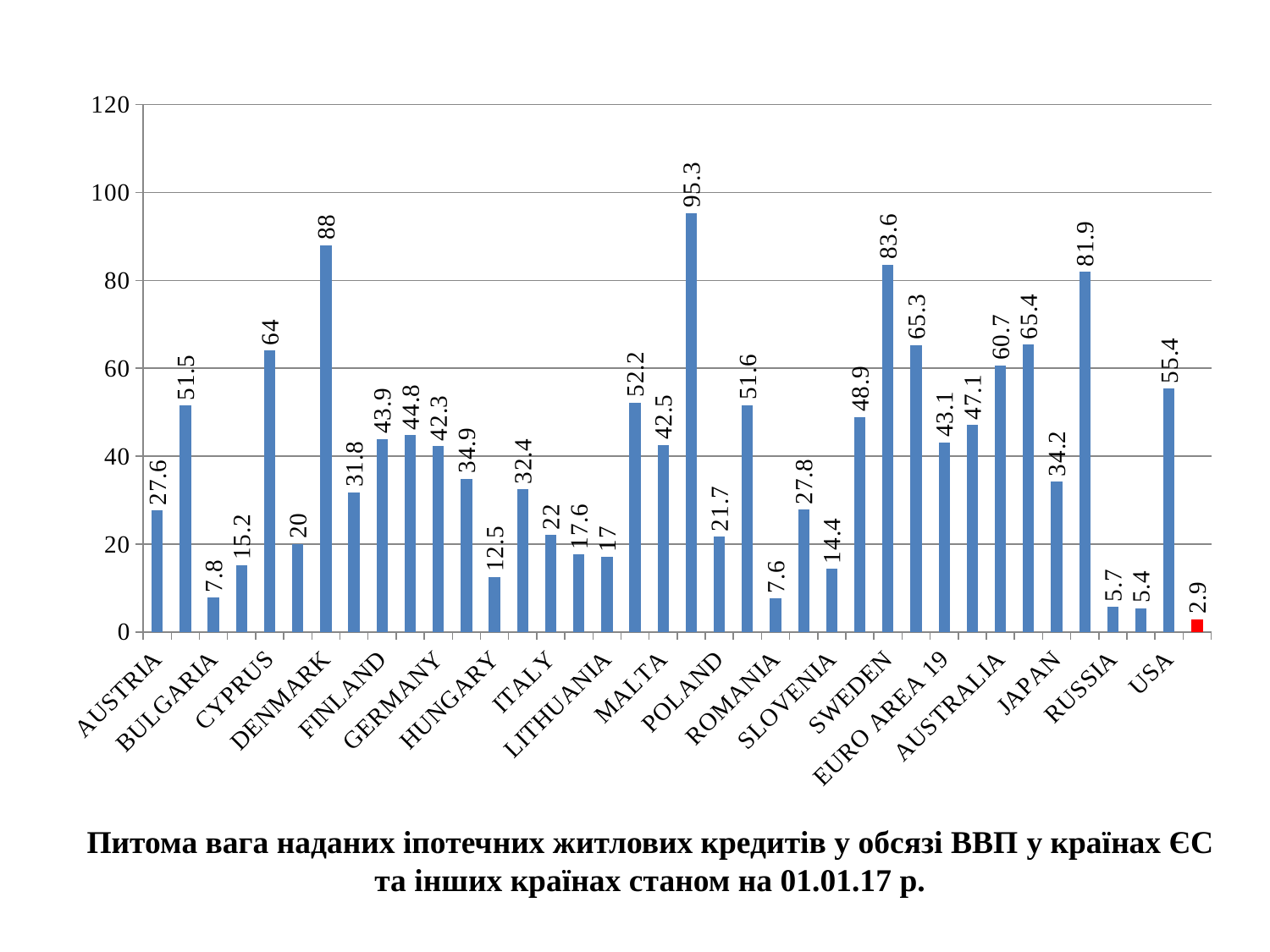
What is the value of the bar for SWEDEN? 83.6 What is the lowest value labelled on any bar in the chart? 2.9 What is the value of the bar for RUSSIA? 5.7 Which has the larger value, CYPRUS or JAPAN? CYPRUS What is the highest value labelled on any bar in the chart? 95.3 What is the value of the bar for GERMANY? 42.3 How many bars are plotted in the chart? 38 What colour is the bar with the value 2.9? red Is the value for AUSTRALIA greater or less than 40? greater What is the value of the bar for DENMARK? 88 What kind of chart is shown on the slide? bar chart What is the difference between the values for DENMARK and SWEDEN? 4.4